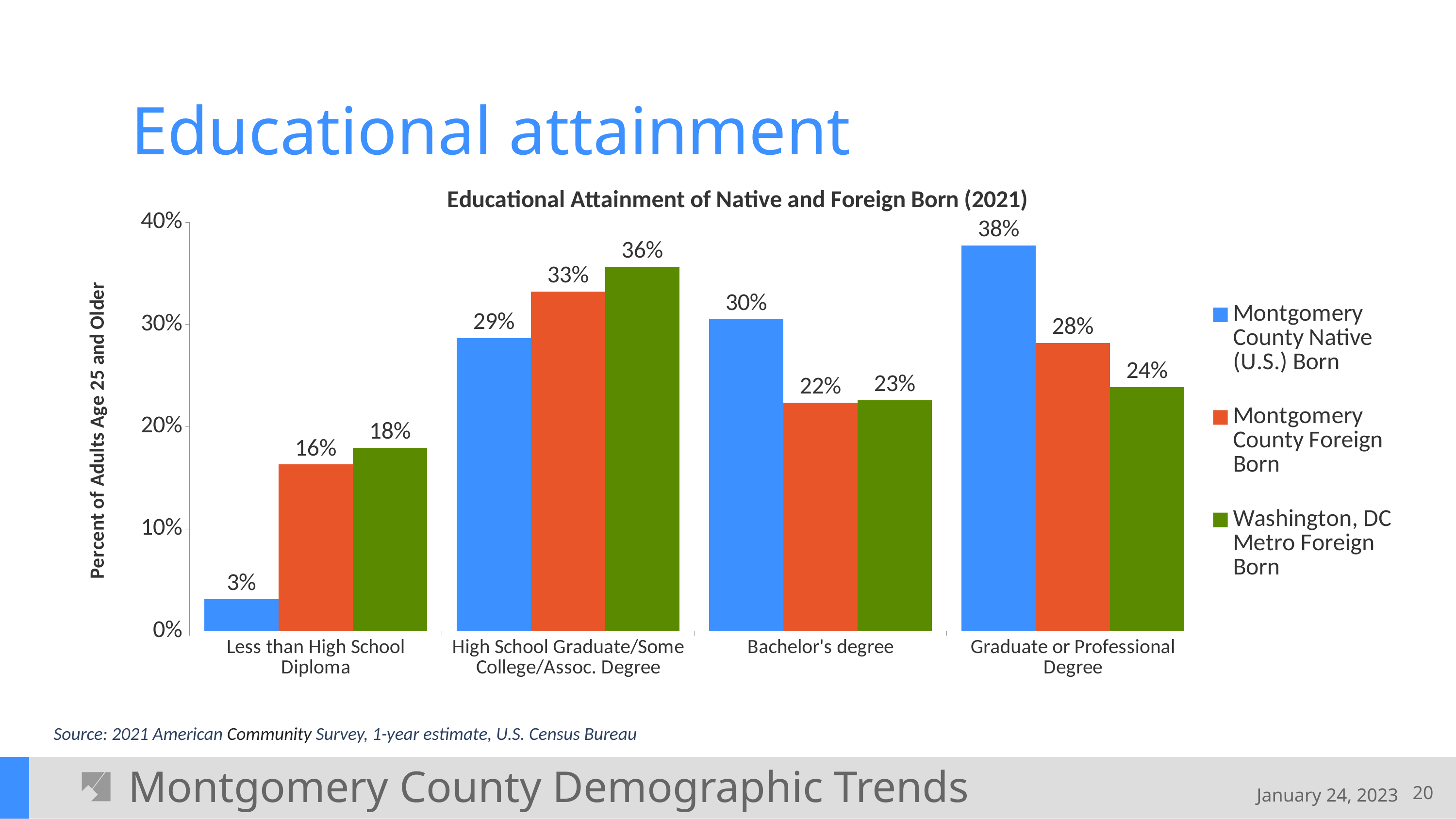
What is the difference between Montgomery County Native (U.S.) Born and Montgomery County Foreign Born in the Graduate or Professional Degree category? 10% In the Less than High School Diploma category, which is larger: Montgomery County Foreign Born or Washington, DC Metro Foreign Born? Washington, DC Metro Foreign Born What is the value for Washington, DC Metro Foreign Born in the High School Graduate/Some College/Assoc. Degree category? 36% Which series has the highest value in the Graduate or Professional Degree category? Montgomery County Native (U.S.) Born What is the title of the chart? Educational Attainment of Native and Foreign Born (2021) Which category has the lowest value for Montgomery County Native (U.S.) Born? Less than High School Diploma How many series does the legend list? 3 Is the value for Montgomery County Native (U.S.) Born in the Graduate or Professional Degree category greater or less than 30%? greater What is the value for Montgomery County Foreign Born in the Bachelor's degree category? 22% How many education categories are shown on the x axis? 4 What is the value for Montgomery County Native (U.S.) Born in the Less than High School Diploma category? 3% What kind of chart is shown on the slide? Bar chart